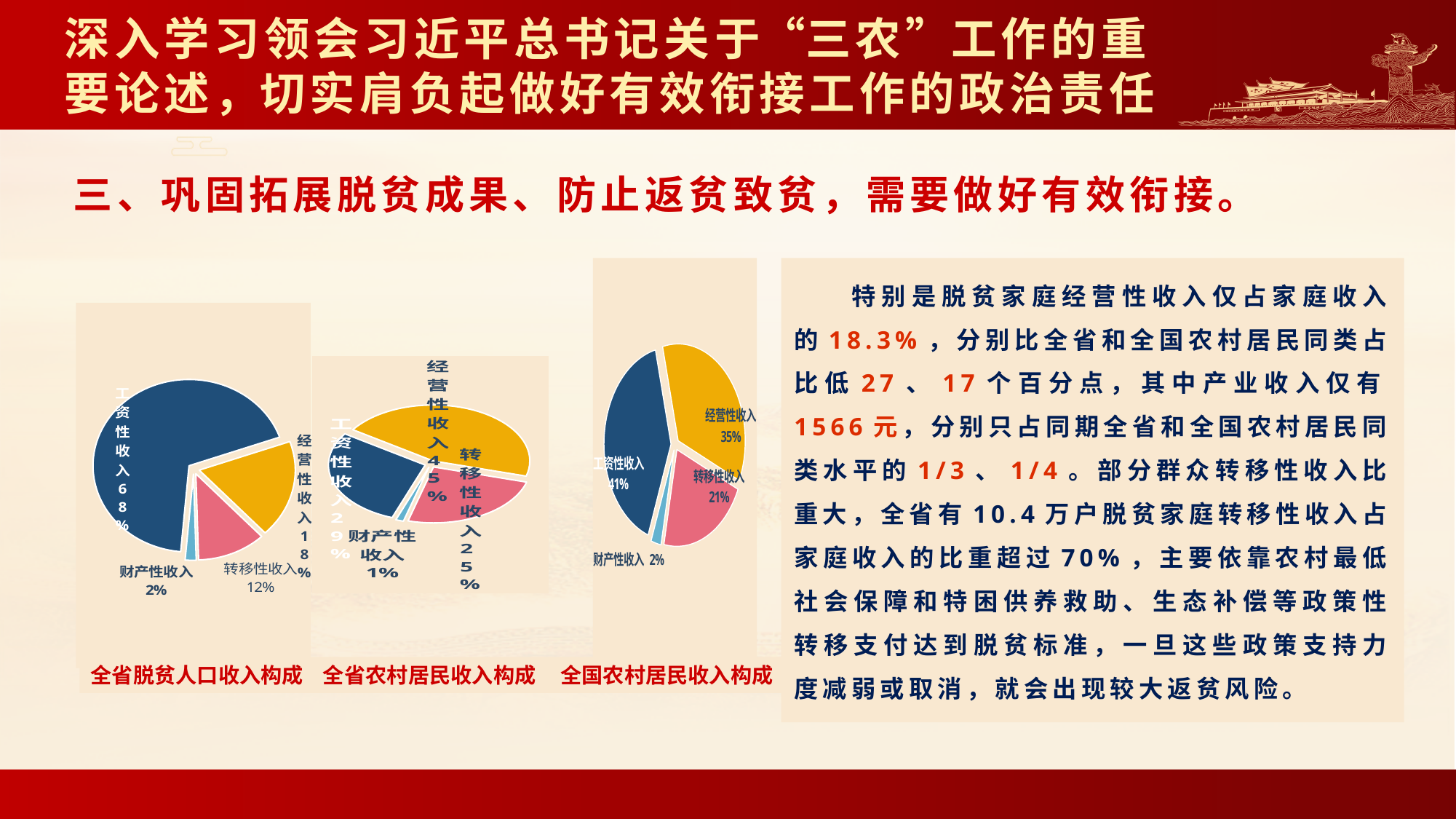
How many categories does the chart titled 全省农村居民收入构成 show? 4 In the chart titled 全省农村居民收入构成, which category has the smallest share? 财产性收入 Which is larger: 经营性收入 in the chart titled 全省农村居民收入构成 or 经营性收入 in the chart titled 全国农村居民收入构成? 全省农村居民收入构成 In the chart titled 全省脱贫人口收入构成, what is the difference between the shares of 工资性收入 and 经营性收入? 50% In the chart titled 全国农村居民收入构成, what share does 转移性收入 have? 21% In the chart titled 全国农村居民收入构成, which category has the largest share? 工资性收入 In the chart titled 全省农村居民收入构成, what share does 经营性收入 have? 45% In the chart titled 全省脱贫人口收入构成, which category has the largest share? 工资性收入 In the chart titled 全省脱贫人口收入构成, what share does 转移性收入 have? 12% In the chart titled 全国农村居民收入构成, what is the difference between the shares of 经营性收入 and 转移性收入? 14% In the chart titled 全省脱贫人口收入构成, what share does 工资性收入 have? 68% What type of chart is the chart titled 全国农村居民收入构成? Pie chart